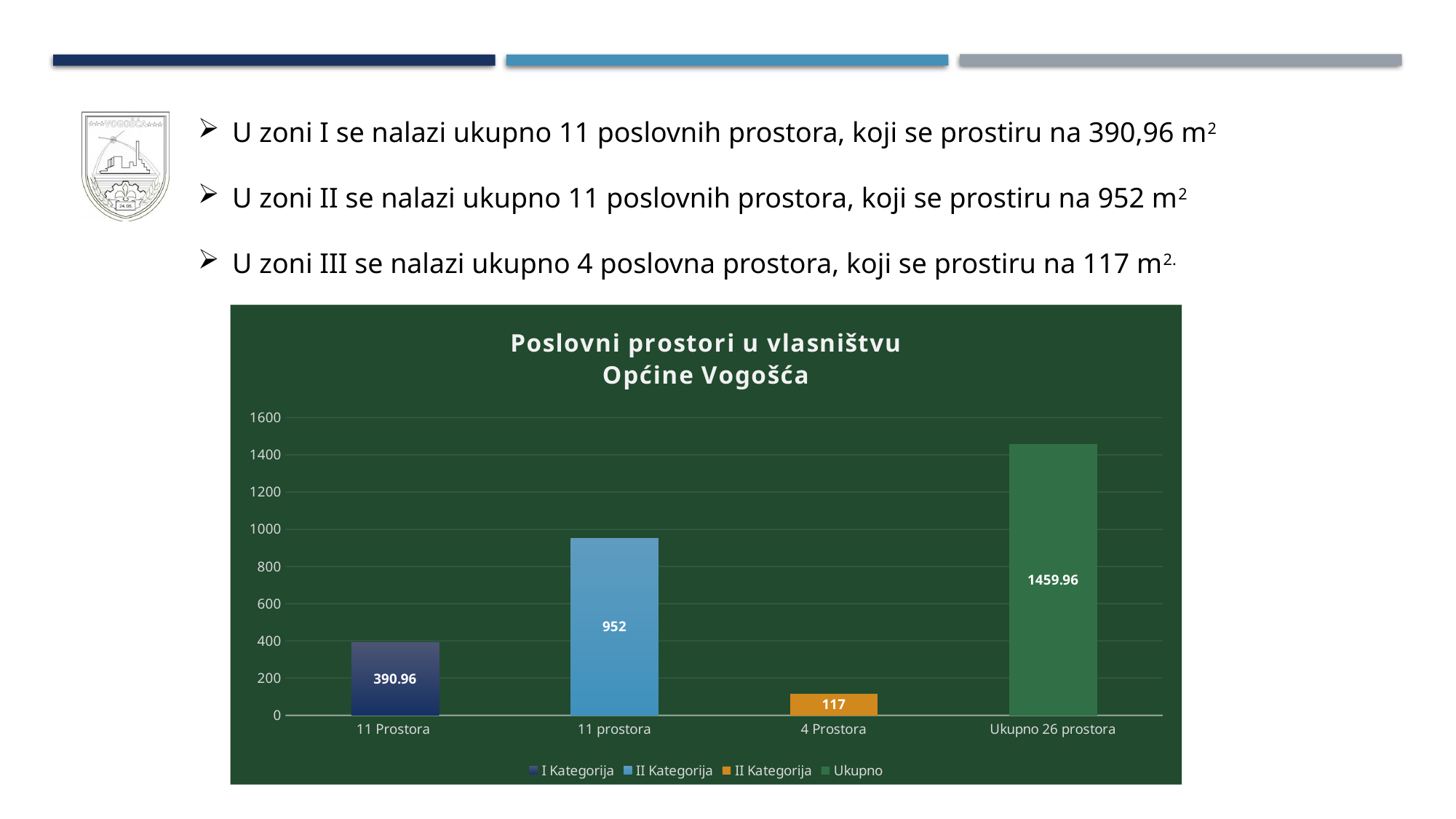
Which is larger, the value for "4 Prostora" or the value for "Ukupno 26 prostora"? Ukupno 26 prostora What type of chart is shown on the slide? bar chart How many entries does the legend list? 4 Which bar has the highest value? Ukupno 26 prostora What is the value shown on the first (dark blue, I Kategorija) bar? 390.96 Which bar has the lowest value? 4 Prostora How many bars are plotted in the chart? 4 What is the value shown for the "Ukupno 26 prostora" bar? 1459.96 Is the value for "Ukupno 26 prostora" greater or less than 1400? greater What is the value shown on the second (light blue) bar labelled "11 prostora"? 952 What is the difference between the second bar (952) and the "4 Prostora" bar (117)? 835 What is the value shown for the "4 Prostora" bar? 117